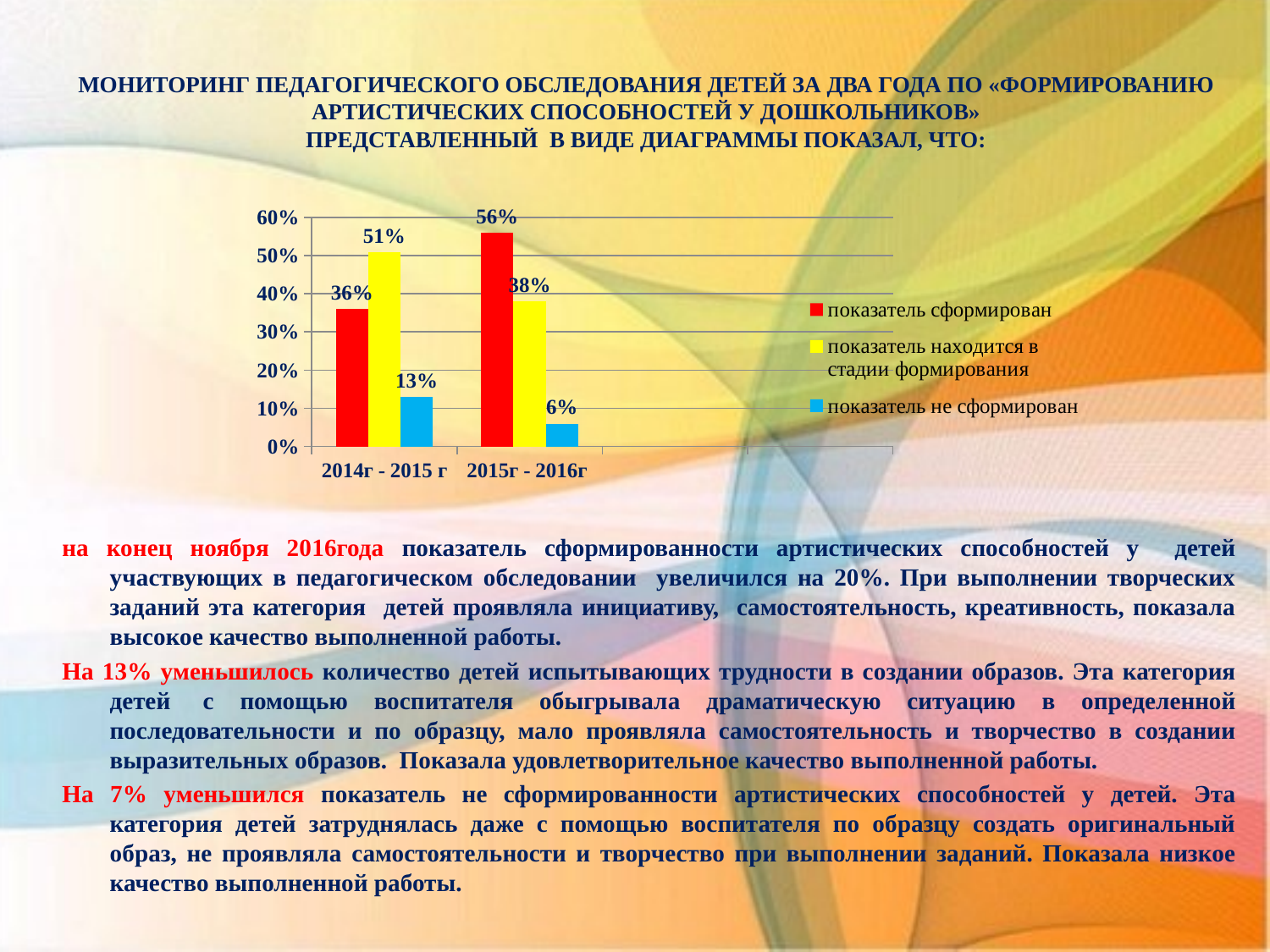
What is the value of «показатель находится в стадии формирования» for 2014г - 2015 г? 51% Which is larger: «показатель находится в стадии формирования» in 2014г - 2015 г or in 2015г - 2016г? 2014г - 2015 г What is the value of «показатель сформирован» for 2015г - 2016г? 56% What kind of chart is shown on the slide? bar chart Which series has the highest value in 2014г - 2015 г? показатель находится в стадии формирования Does «показатель не сформирован» rise or fall from 2014г - 2015 г to 2015г - 2016г? fall What is the value of «показатель не сформирован» for 2015г - 2016г? 6% How many series does the legend list? 3 What is the difference between «показатель не сформирован» in 2014г - 2015 г and in 2015г - 2016г? 7% By how much did «показатель сформирован» change from 2014г - 2015 г to 2015г - 2016г? 20% Which series has the lowest value in 2015г - 2016г? показатель не сформирован What is the value of «показатель сформирован» for 2014г - 2015 г? 36%